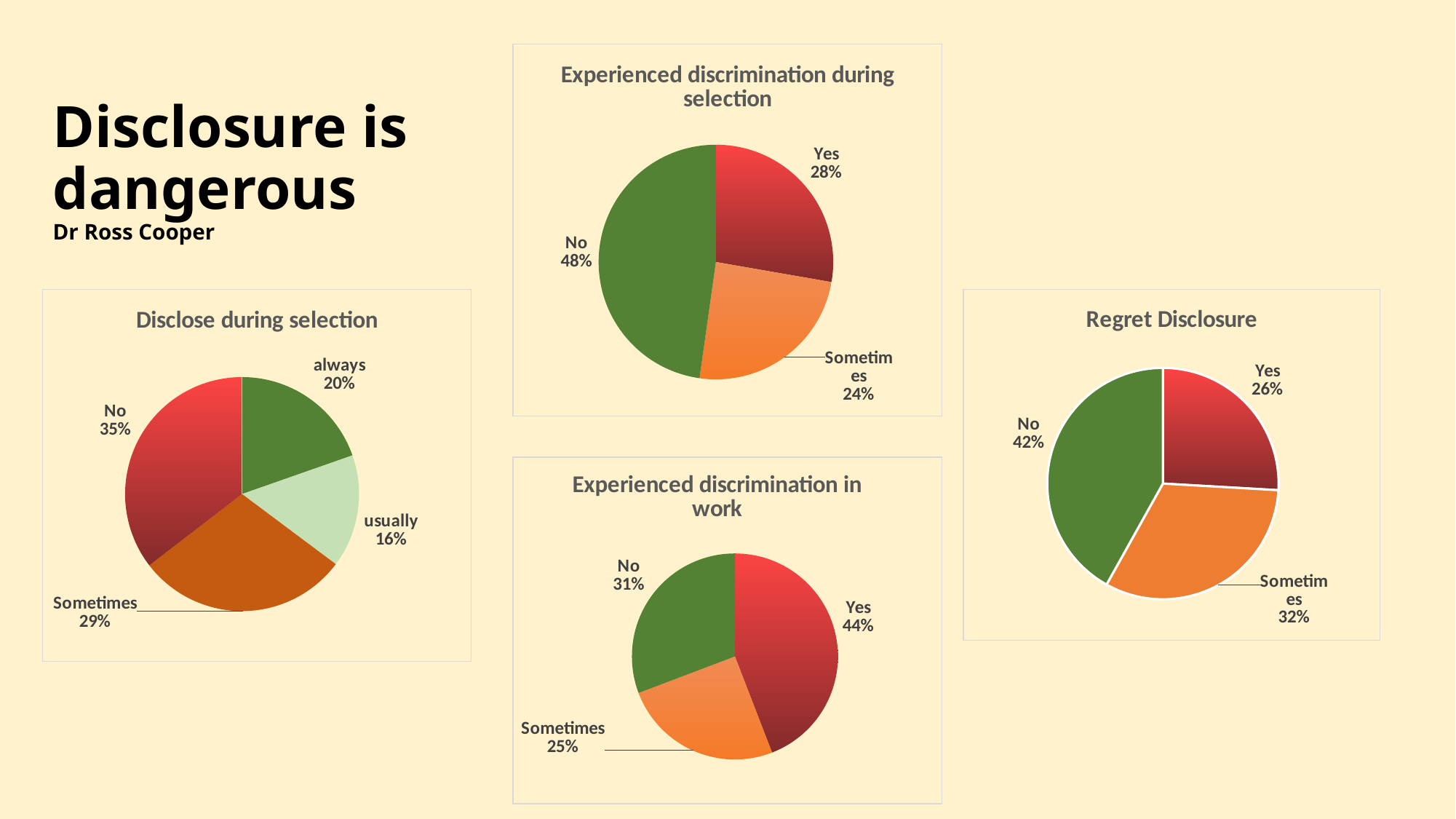
In the 'Experienced discrimination in work' chart, which is larger, 'No' or 'Sometimes'? No In the 'Disclose during selection' chart, which category has the smallest share? usually In the 'Regret Disclosure' chart, what share is labelled 'Sometimes'? 32% In the 'Experienced discrimination in work' chart, which category has the largest share? Yes In the 'Experienced discrimination during selection' chart, what is the difference between the 'Yes' and 'Sometimes' shares? 4% How many slices does the 'Disclose during selection' pie chart have? 4 In the 'Regret Disclosure' chart, what is the difference between the 'No' and 'Yes' shares? 16% In the 'Experienced discrimination in work' chart, what share is labelled 'Sometimes'? 25% How many charts are shown on the slide? 4 In the 'Disclose during selection' chart, what share is labelled 'No'? 35% What kind of chart is the 'Regret Disclosure' chart? Pie chart In the 'Experienced discrimination during selection' chart, what share is labelled 'No'? 48%